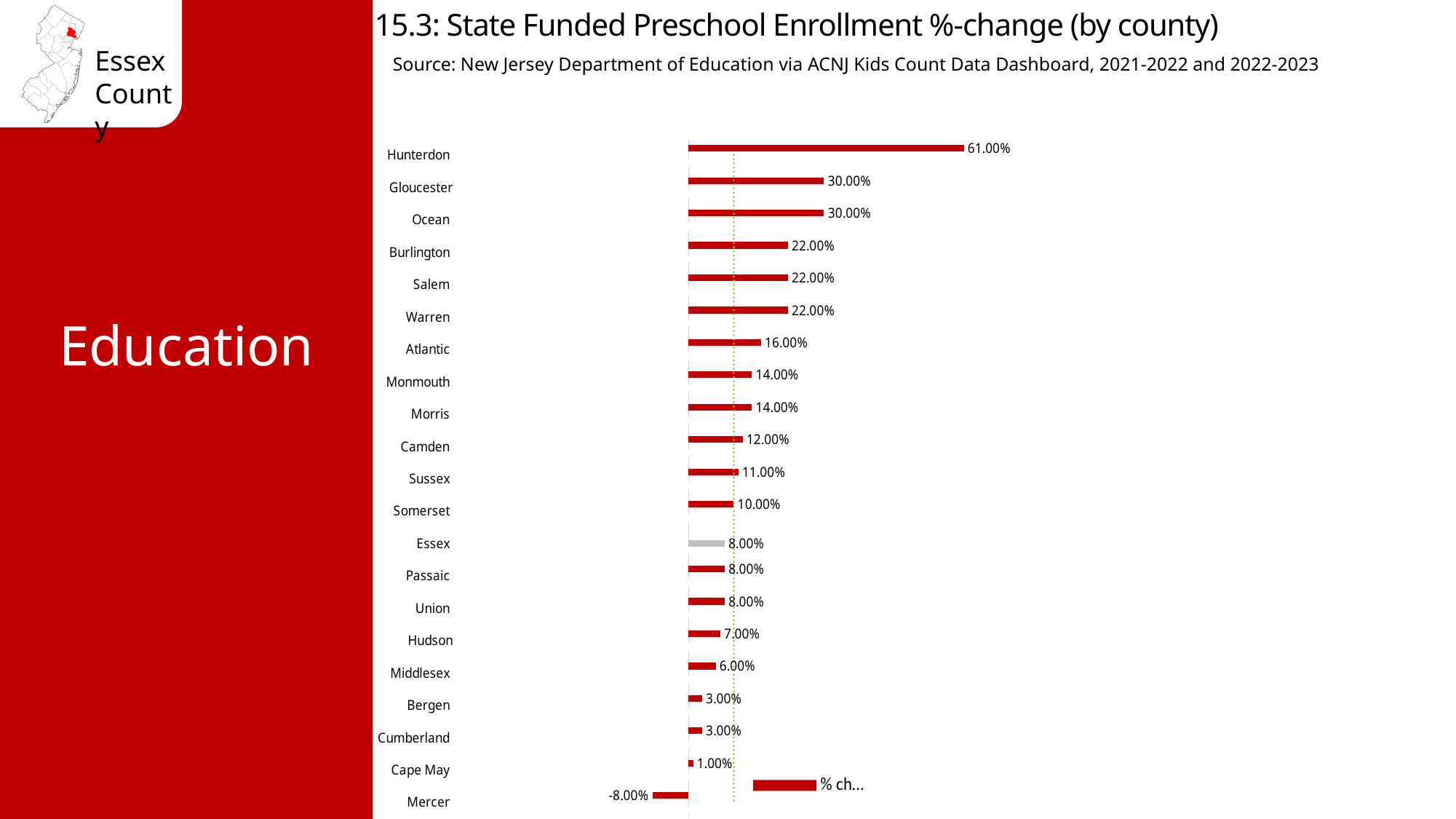
What is the difference between the %-change for Essex and Mercer? 16.00% What is the state funded preschool enrollment %-change for Hunterdon? 61.00% What is the %-change value shown for Atlantic? 16.00% Which has a larger %-change, Atlantic or Camden? Atlantic What kind of chart is shown on the slide? Bar chart What is the %-change value shown for Essex? 8.00% Which county has the lowest %-change in state funded preschool enrollment? Mercer Which county's bar is coloured grey instead of red? Essex Which county has the highest %-change in state funded preschool enrollment? Hunterdon What is the %-change value shown for Mercer? -8.00% How many counties are shown in the chart? 21 What is the difference between the %-change for Hunterdon and Gloucester? 31.00%